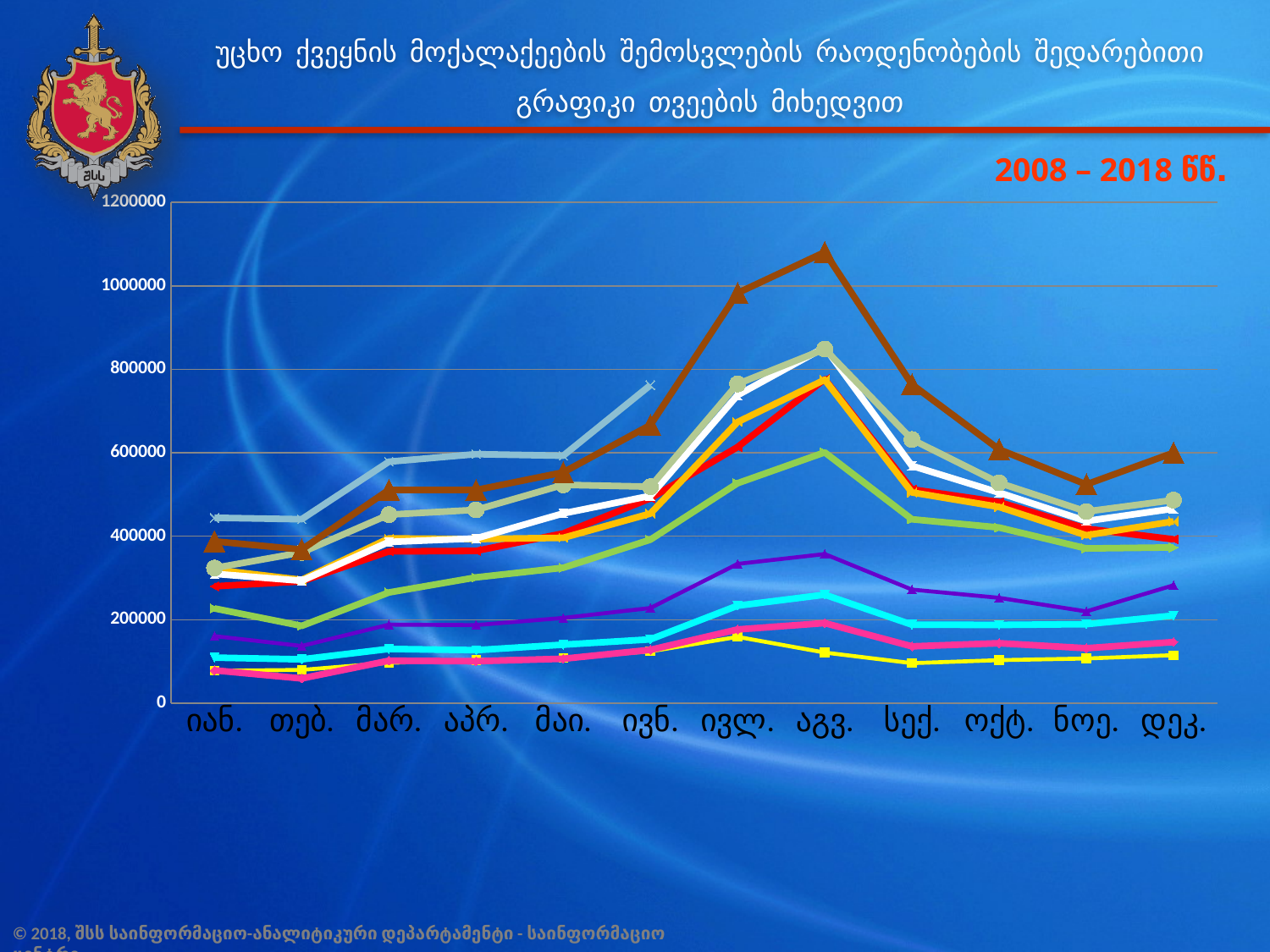
Is the value of the yellow line in აგვ. greater or less than 200000? less Is the value of the pink line in თებ. greater or less than 100000? less In which month does the dark brown line with triangle markers reach its highest value? აგვ. In აგვ., which is larger: the value of the dark brown line or the value of the yellow line? the dark brown line Does the dark brown line with triangle markers rise or fall from იან. to აგვ.? rise What kind of chart is shown on the slide? line chart Is the value of the cyan line in აგვ. greater or less than 200000? greater What year range is shown in red above the chart? 2008 – 2018 წწ. Which line has the lowest values across most of the months? the yellow line How many months are shown along the x axis of the chart? 12